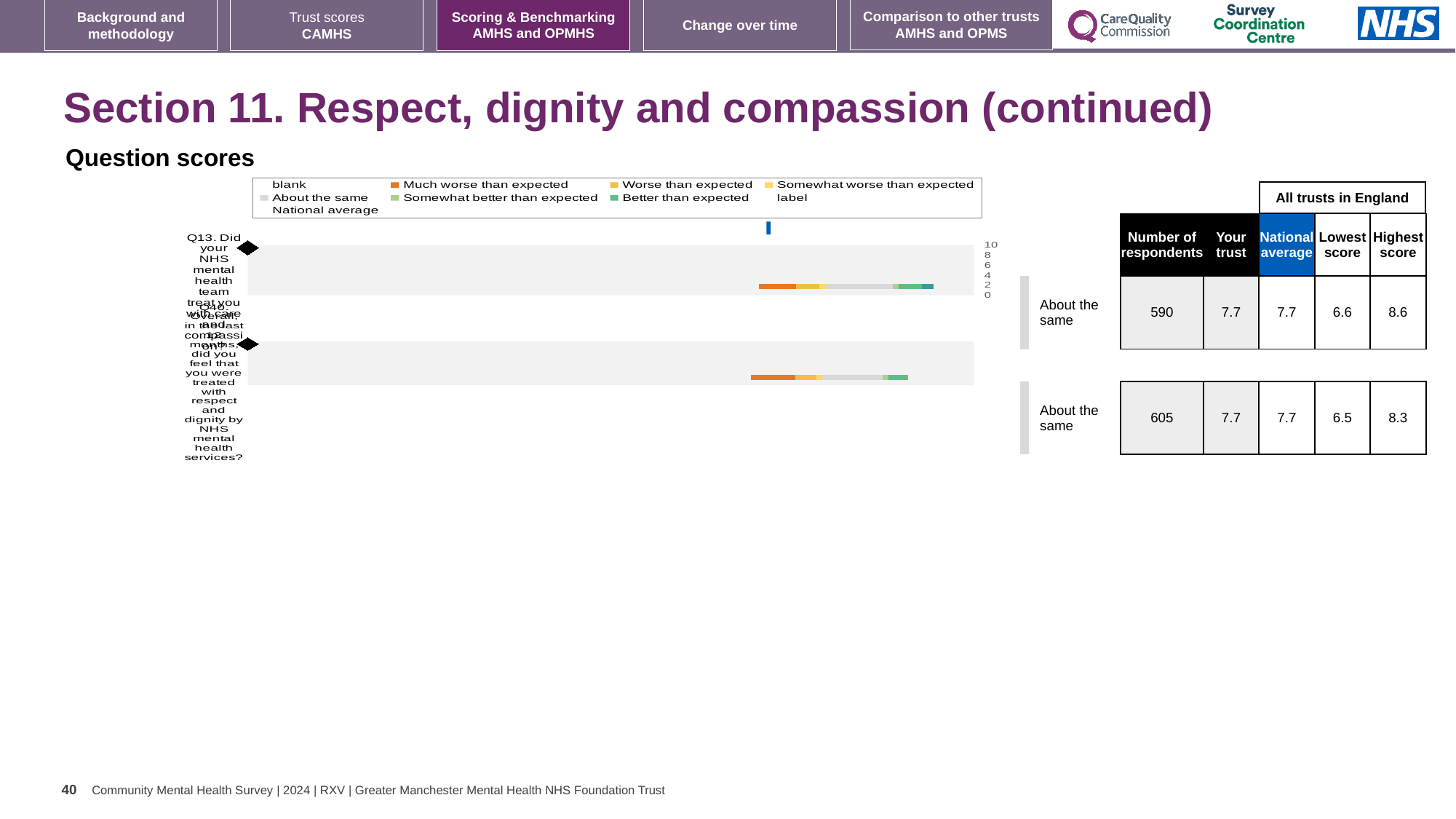
What is the difference between the highest scores of the first row (8.6) and the second row (8.3) in the table? 0.3 How many question bars are plotted in the chart? 2 What heading appears above the 'National average', 'Lowest score' and 'Highest score' columns in the table? All trusts in England In the table beside the chart, what is the number of respondents for the second (bottom) question row? 605 In the table beside the chart, what is the lowest score for the second (bottom) question row? 6.5 Which question row has more respondents in the table, the first (top) or the second (bottom)? the second (bottom) row In the table beside the chart, what is the 'Your trust' score for the first (top) question row? 7.7 In the table beside the chart, what is the number of respondents for the first (top) question row? 590 In the table beside the chart, what is the highest score for the first (top) question row? 8.6 Which question row has the larger highest score in the table, the first (top) or the second (bottom)? the first (top) row What kind of chart is shown under 'Question scores'? bar chart What benchmark category label is shown next to the first (top) question bar? About the same